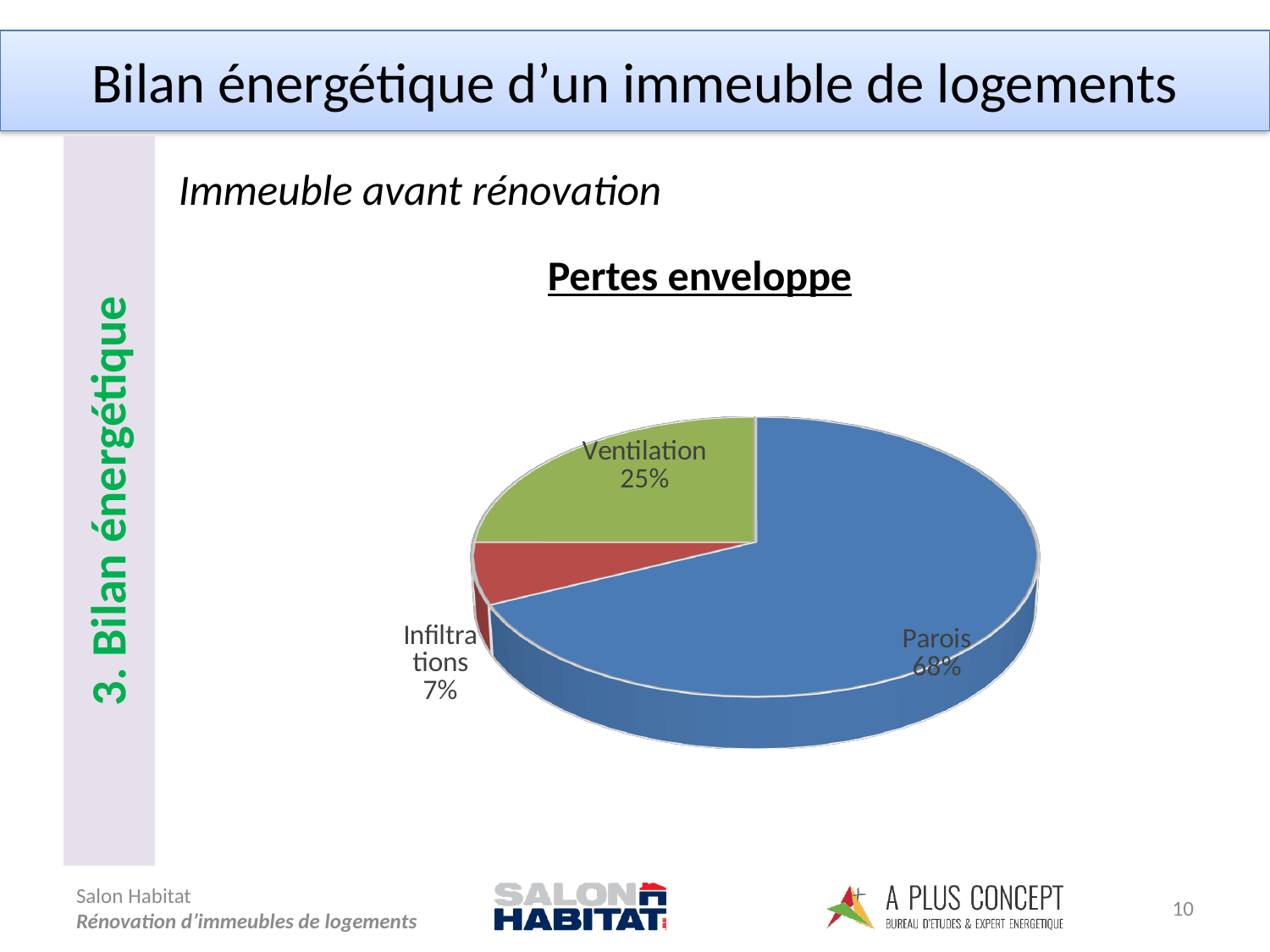
What colour is the Ventilation slice? Green What share of the pie does Ventilation represent? 25% How many categories are shown in the pie chart? 3 What is the title of the chart? Pertes enveloppe What kind of chart is shown on the slide? Pie chart What is the difference in percentage points between Parois and Ventilation? 43 Which category has the smallest slice of the pie? Infiltrations What share of the pie does Parois represent? 68% Which is larger, the share for Ventilation or the share for Infiltrations? Ventilation What is the difference in percentage points between Ventilation and Infiltrations? 18 What share of the pie does Infiltrations represent? 7% Which category has the largest slice of the pie? Parois